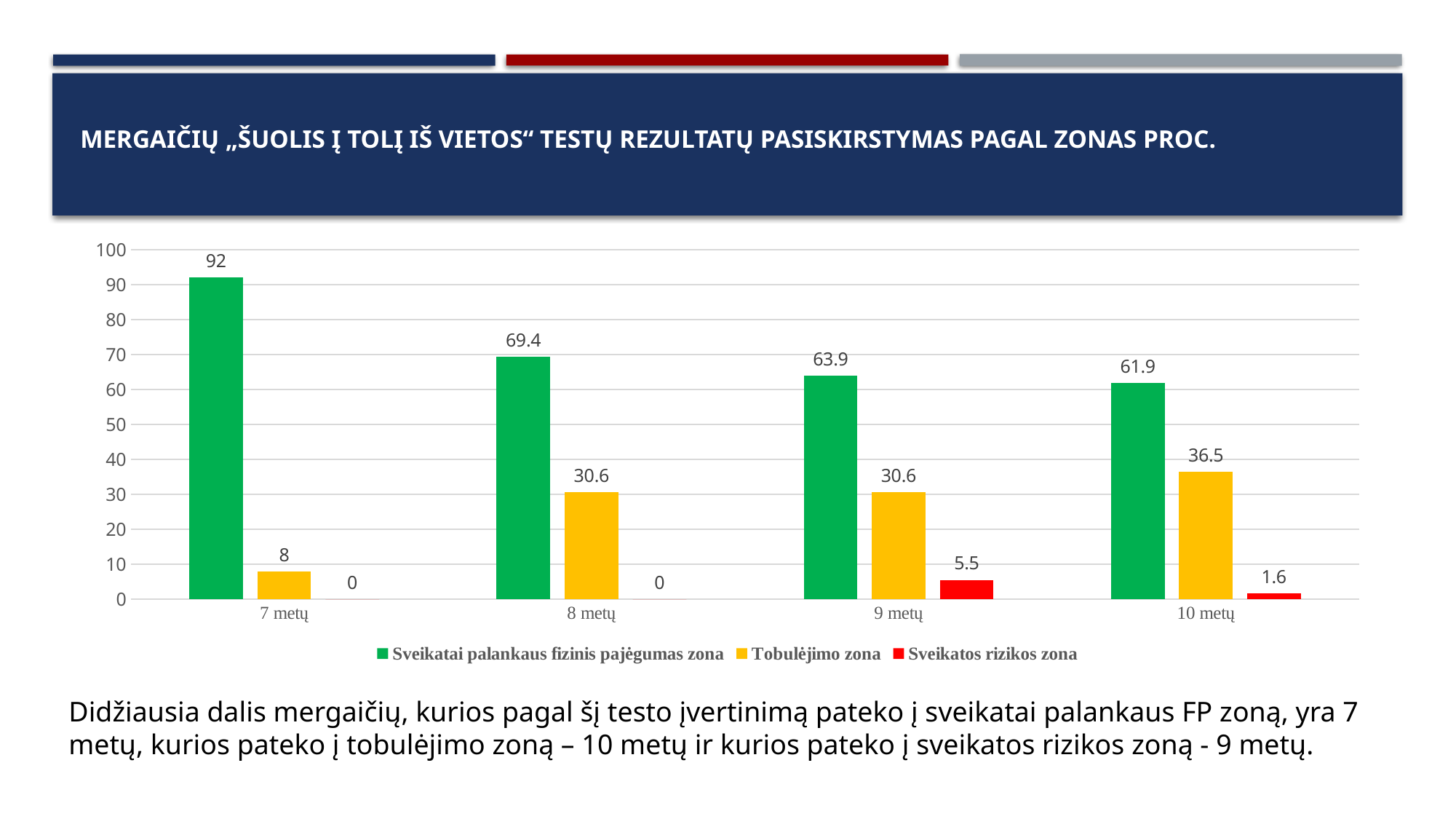
Which age group has the highest value for 'Sveikatai palankaus fizinis pajėgumas zona'? 7 metų What is the value for 'Sveikatai palankaus fizinis pajėgumas zona' at 7 metų? 92 What colour are the bars for 'Sveikatos rizikos zona'? red Which age group has the lowest value for 'Tobulėjimo zona'? 7 metų Do the values for 'Sveikatai palankaus fizinis pajėgumas zona' rise or fall from 7 metų to 10 metų? fall What is the value for 'Tobulėjimo zona' at 10 metų? 36.5 What is the value for 'Sveikatos rizikos zona' at 9 metų? 5.5 Which is larger: 'Tobulėjimo zona' at 10 metų or 'Tobulėjimo zona' at 9 metų? 10 metų How many series does the legend list? 3 How many age groups are shown on the x axis? 4 What kind of chart is shown on the slide? bar chart What is the difference between the 'Sveikatai palankaus fizinis pajėgumas zona' values for 7 metų and 8 metų? 22.6